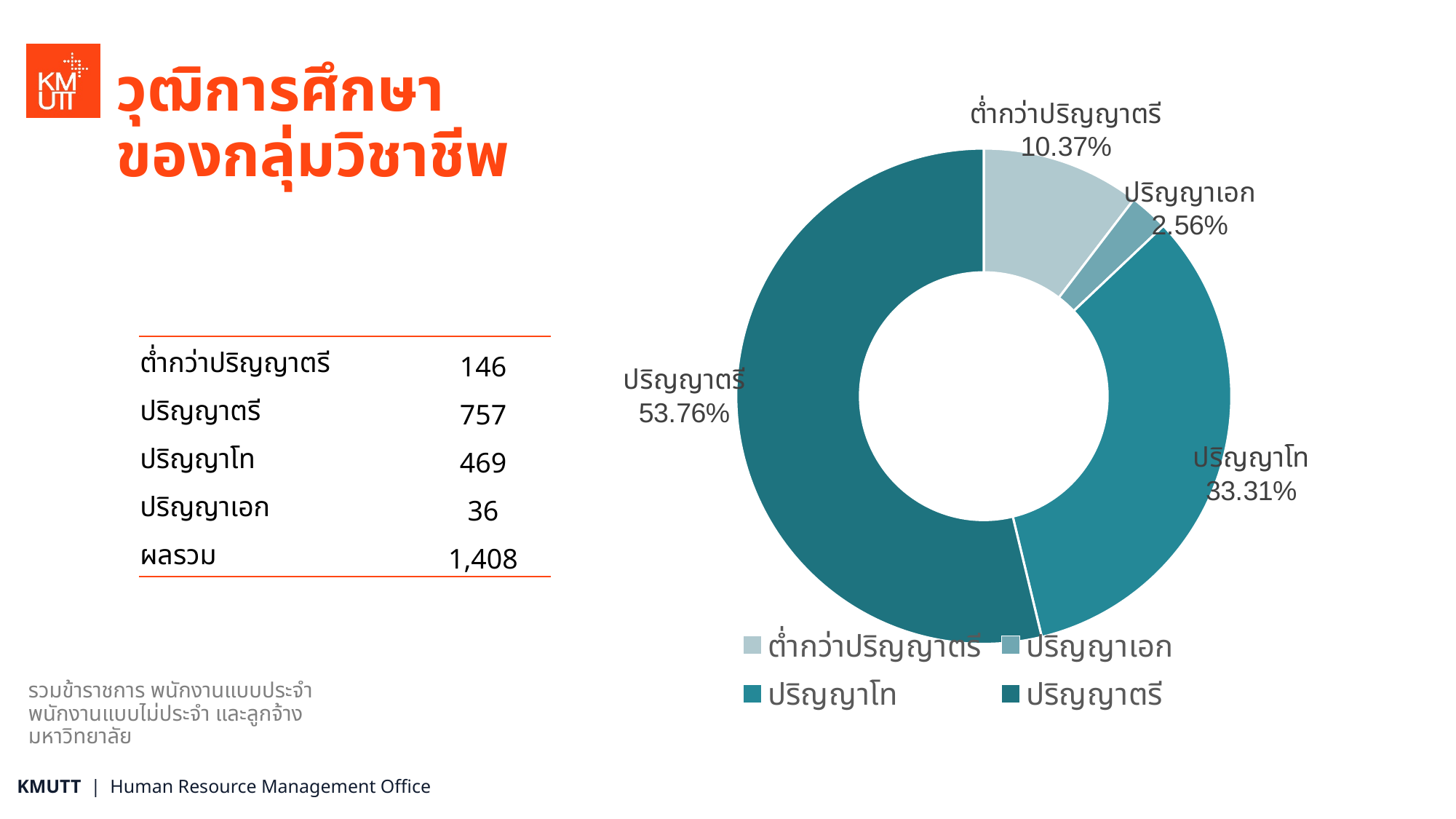
What is the difference in percentage points between the ปริญญาตรี slice and the ปริญญาโท slice? 20.45 What share of the doughnut chart does ปริญญาตรี represent? 53.76% What percentage is shown for ปริญญาเอก on the chart? 2.56% What percentage is shown for ต่ำกว่าปริญญาตรี on the chart? 10.37% Which slice is larger, ปริญญาโท or ต่ำกว่าปริญญาตรี? ปริญญาโท Which category has the largest slice of the chart? ปริญญาตรี According to the table on the slide, what is the total (ผลรวม) count? 1,408 Which category has the smallest slice of the chart? ปริญญาเอก What type of chart is shown on the slide? Doughnut (pie) chart How many categories are shown in the chart? 4 What share of the doughnut chart does ปริญญาโท represent? 33.31% How many entries does the chart legend list? 4